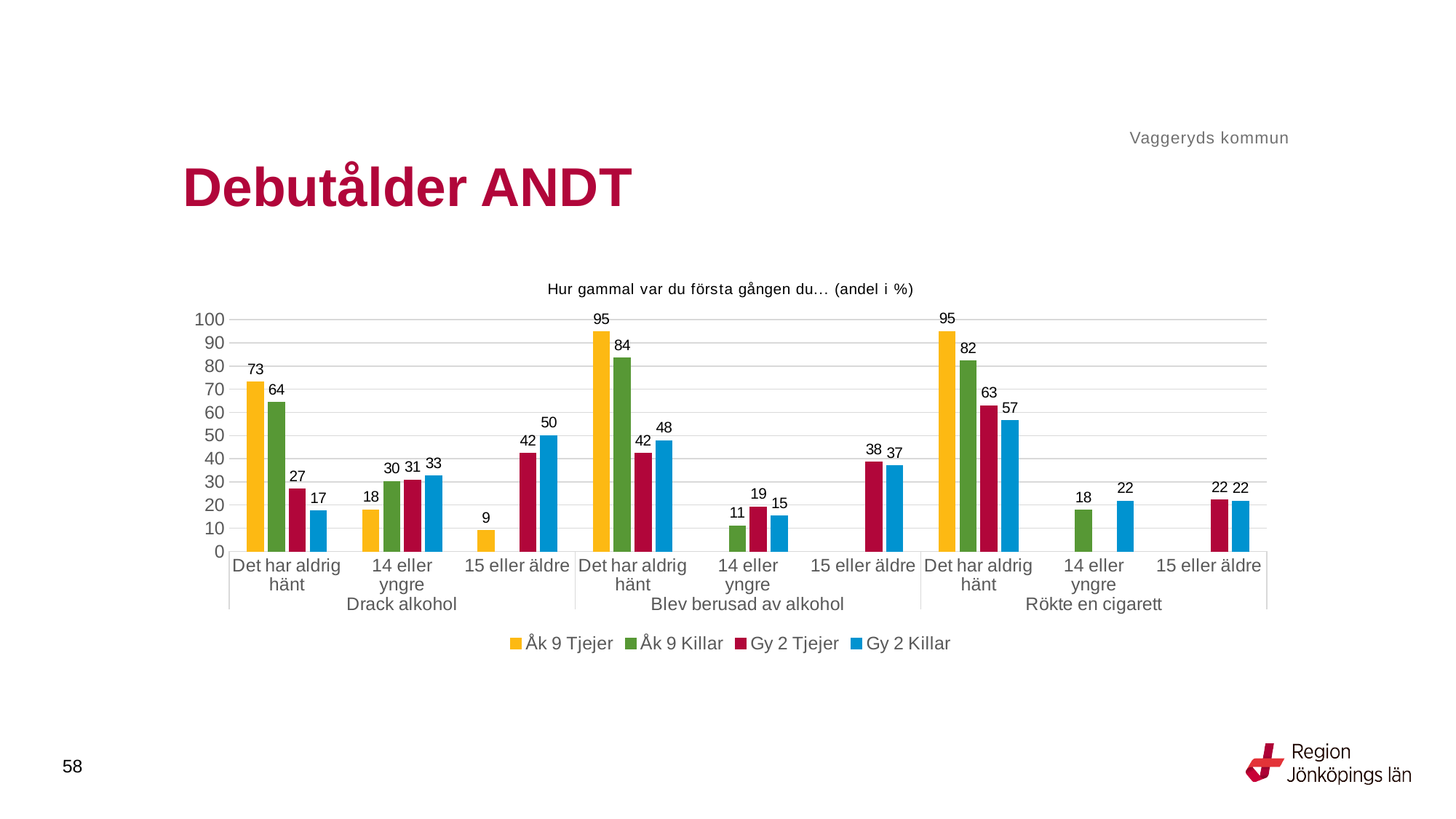
How many series does the legend list? 4 What is the value for Gy 2 Tjejer for 'Det har aldrig hänt' under 'Rökte en cigarett'? 63 What is the value for Åk 9 Killar for '14 eller yngre' under 'Blev berusad av alkohol'? 11 What is the value for Gy 2 Killar for '15 eller äldre' under 'Drack alkohol'? 50 What is the difference between Åk 9 Tjejer and Åk 9 Killar for 'Det har aldrig hänt' under 'Rökte en cigarett'? 13 What kind of chart is shown on the slide? Bar chart Which series has the highest value for 'Det har aldrig hänt' under 'Blev berusad av alkohol'? Åk 9 Tjejer What is the title of the chart? Hur gammal var du första gången du… (andel i %) What is the value for Åk 9 Tjejer for 'Det har aldrig hänt' under 'Drack alkohol'? 73 Is the value for Åk 9 Killar for 'Det har aldrig hänt' under 'Blev berusad av alkohol' greater or less than 80? greater Which series has the lowest value for 'Det har aldrig hänt' under 'Drack alkohol'? Gy 2 Killar Which is larger for 'Det har aldrig hänt' under 'Blev berusad av alkohol': Gy 2 Tjejer or Gy 2 Killar? Gy 2 Killar